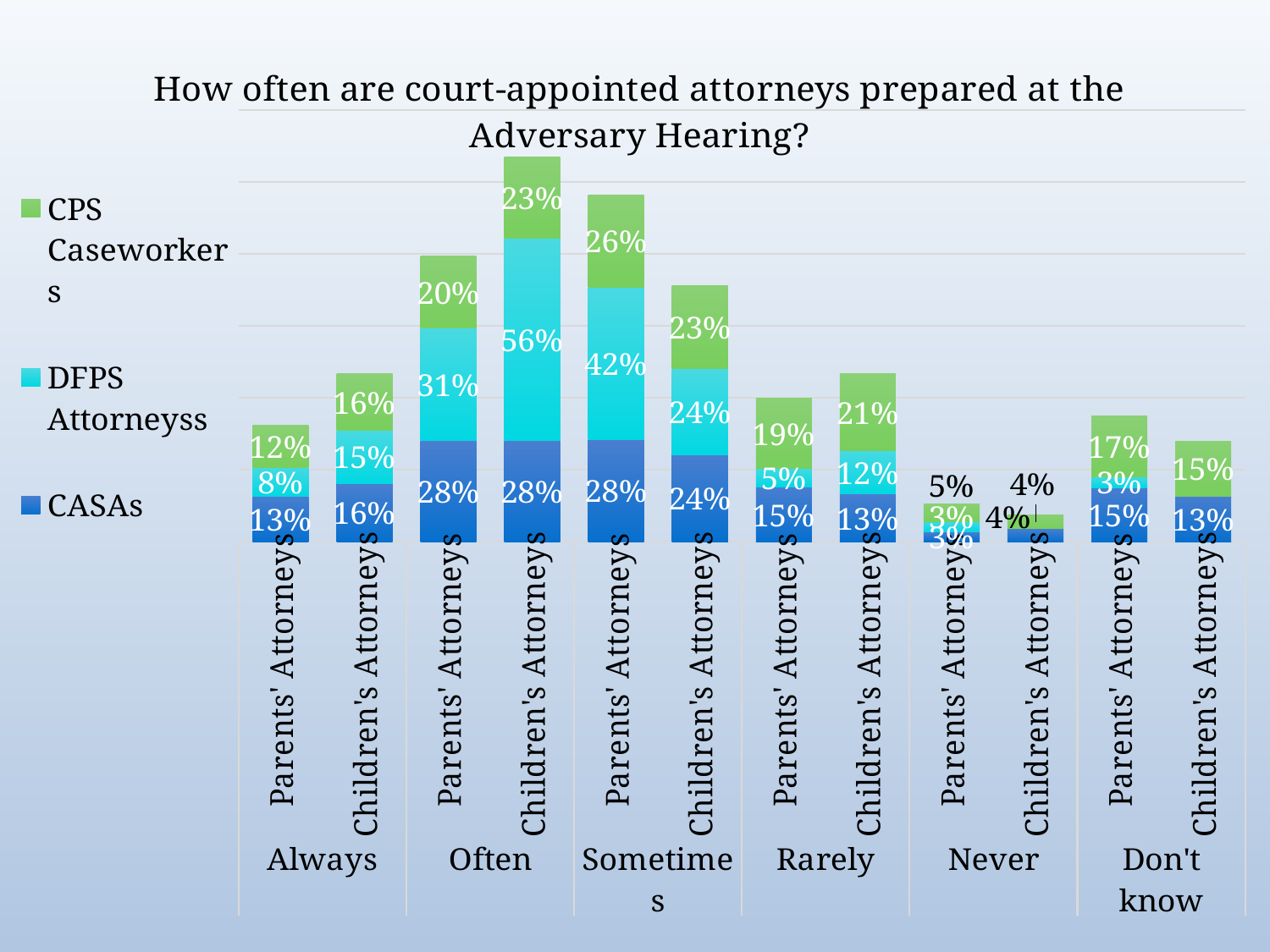
What is the title of the chart? How often are court-appointed attorneys prepared at the Adversary Hearing? What is the difference between the DFPS Attorneys values for Children's Attorneys and Parents' Attorneys under Often? 25% Which frequency category has the tallest stacked bar for Children's Attorneys? Often How many series does the legend list? 3 What is the DFPS Attorneys value for Parents' Attorneys under Sometimes? 42% What is the CPS Caseworkers value for Children's Attorneys under Rarely? 21% Which is larger: the CPS Caseworkers value for Parents' Attorneys under Sometimes or under Rarely? Sometimes What is the DFPS Attorneys value for Children's Attorneys under Often? 56% What is the CASAs value for Parents' Attorneys under Always? 13% What is the total of the stacked bar for Parents' Attorneys under Always? 33% How many frequency categories are shown along the x axis? 6 What kind of chart is shown on the slide? Stacked bar chart